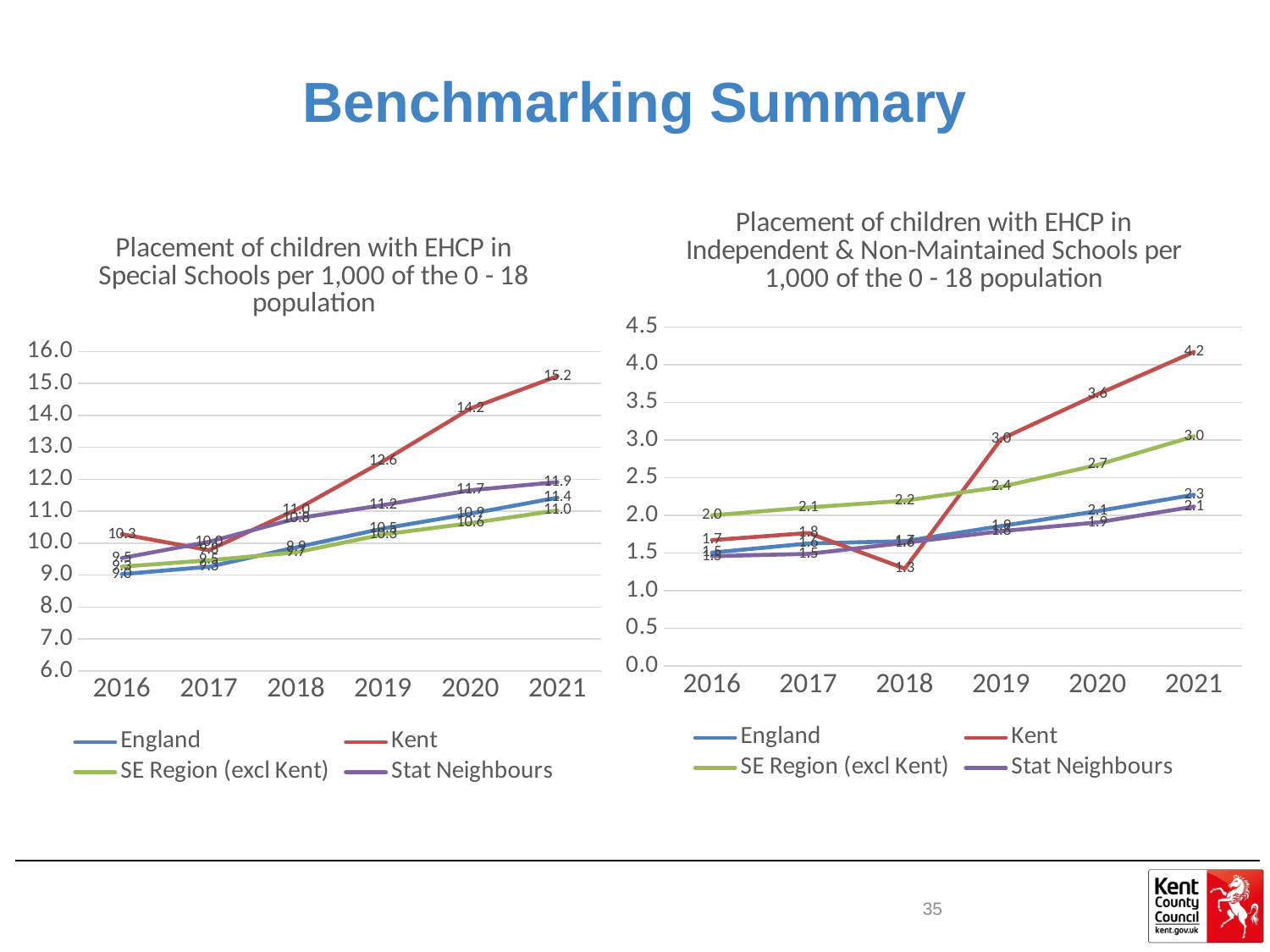
In the right chart (Independent & Non-Maintained Schools), does the SE Region (excl Kent) line rise or fall from 2016 to 2021? Rise In the left chart (Special Schools), what is the value for Kent in 2021? 15.2 In the right chart (Independent & Non-Maintained Schools), what is the value for Kent in 2018? 1.3 In the left chart (Special Schools), what is the value for Kent in 2019? 12.6 In the right chart (Independent & Non-Maintained Schools), what is the value for Kent in 2021? 4.2 In the right chart (Independent & Non-Maintained Schools), which is larger in 2020: Kent or SE Region (excl Kent)? Kent In the right chart (Independent & Non-Maintained Schools), which series has the lowest value in 2018? Kent In the left chart (Special Schools), which series has the highest value in 2021? Kent In the left chart (Special Schools), what is the difference between Kent and Stat Neighbours in 2021? 3.3 What kind of chart is the left chart, 'Placement of children with EHCP in Special Schools per 1,000 of the 0 - 18 population'? Line chart How many series does the legend of the left chart (Special Schools) list? 4 How many years are shown on the x axis of the left chart (Special Schools)? 6